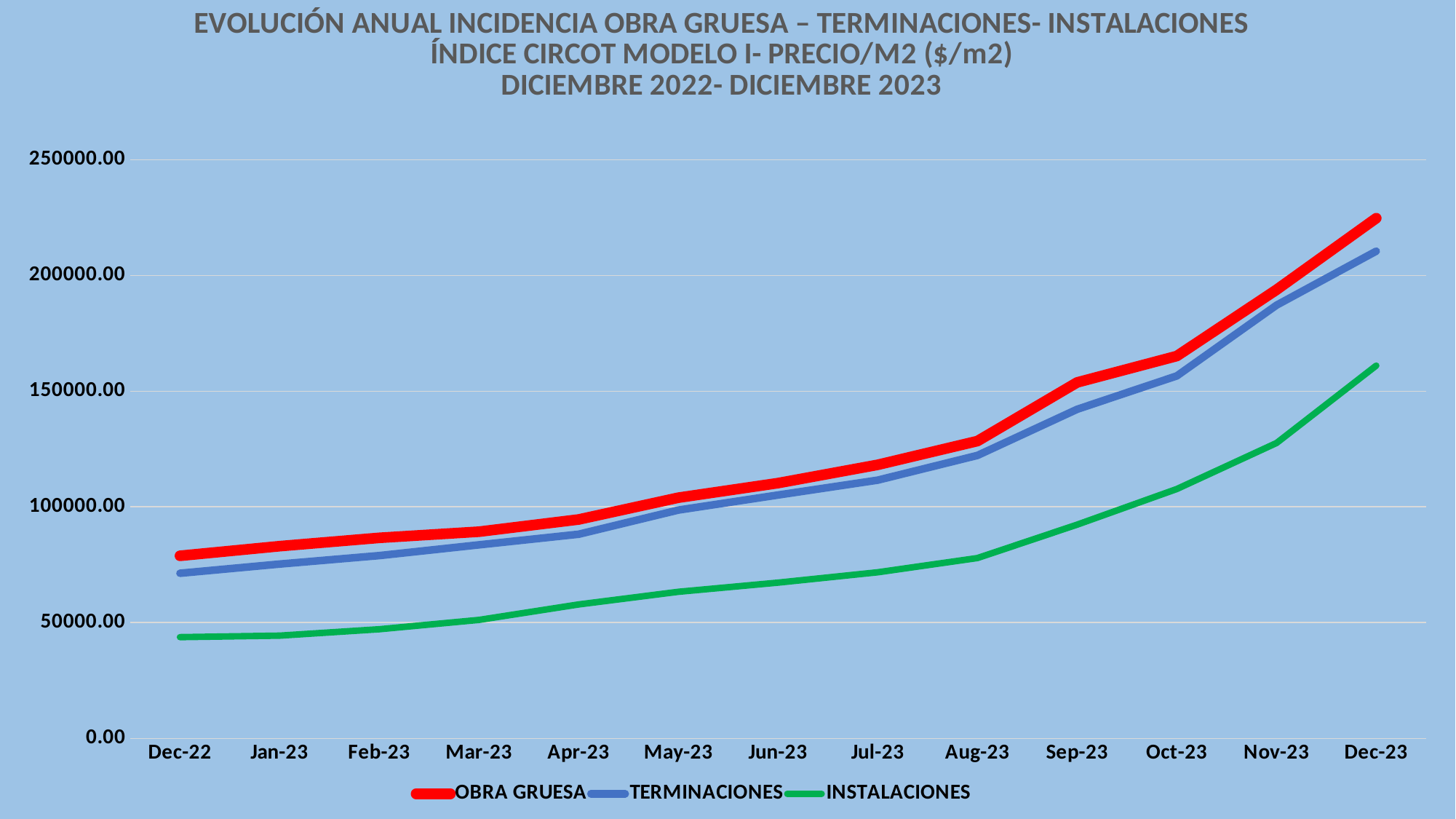
Do the values for TERMINACIONES rise or fall from Dec-22 to Dec-23? rise What colour is the INSTALACIONES line? green Which series has the highest value in Dec-23? OBRA GRUESA Is the value for INSTALACIONES in Aug-23 greater or less than 100000.00? less How many series does the legend list? 3 Which series has the lowest value in Dec-22? INSTALACIONES How many months are plotted along the x axis? 13 Is the value for OBRA GRUESA in Dec-22 greater or less than 100000.00? less Which is larger in Jun-23, OBRA GRUESA or INSTALACIONES? OBRA GRUESA Is the value for INSTALACIONES in Dec-22 greater or less than 50000.00? less What kind of chart is shown on the slide? line chart